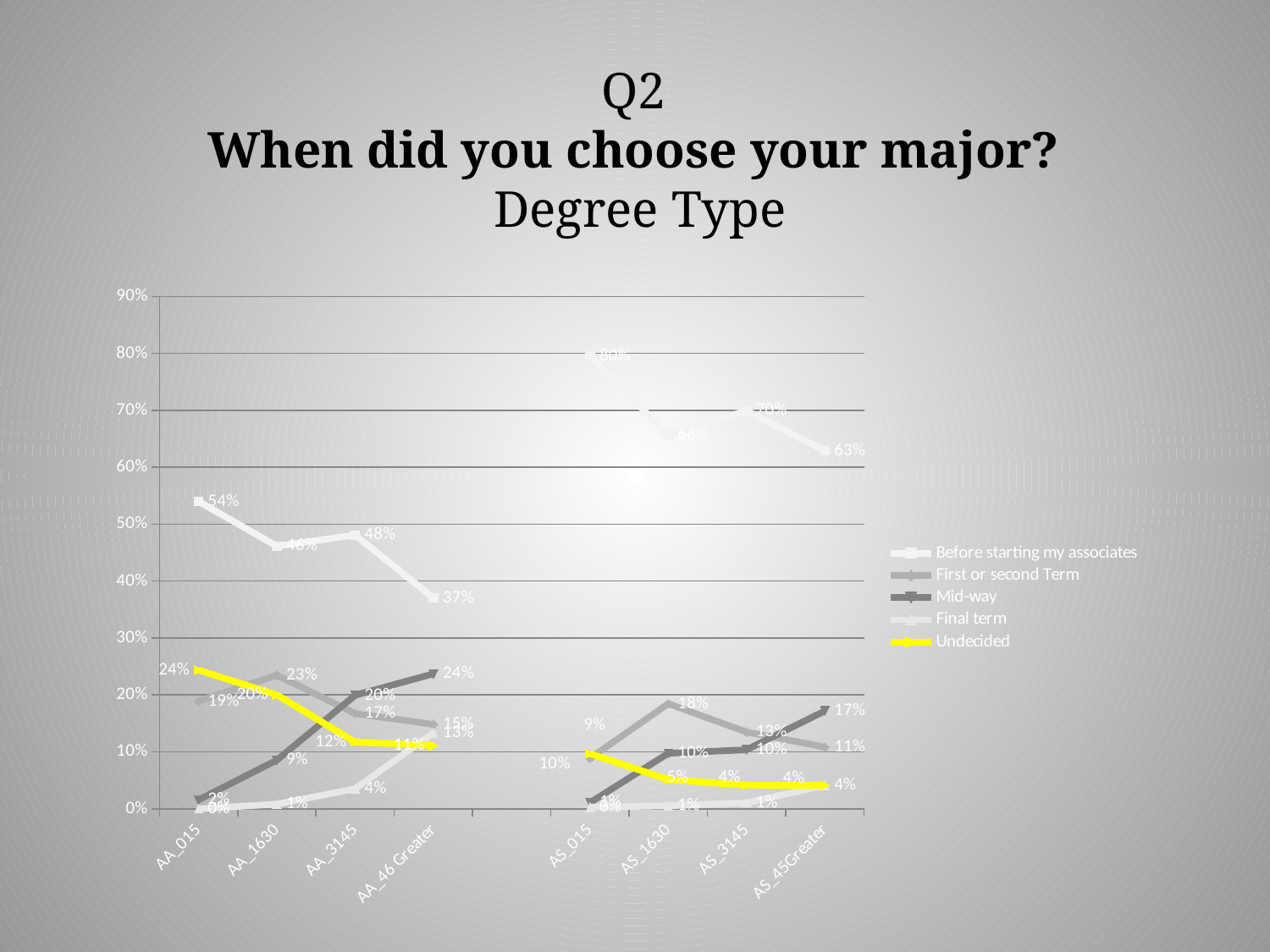
What kind of chart is shown on the slide? line chart What is the value for 'Undecided' at AS_45Greater? 4% What is the value for 'Before starting my associates' at AA_46 Greater? 37% What is the difference between the 'Before starting my associates' values at AS_015 and AS_45Greater? 17 percentage points At AA_46 Greater, which is larger: 'Mid-way' or 'Undecided'? Mid-way What is the value for 'Before starting my associates' at AS_015? 80% Does the 'Undecided' series rise or fall from AA_015 to AA_46 Greater? fall What colour is the 'Undecided' line in the legend? yellow At which category does the 'Before starting my associates' series reach its highest value? AS_015 How many series does the legend list? 5 What is the value for 'Mid-way' at AS_45Greater? 17% What is the value for 'Undecided' at AA_015? 24%